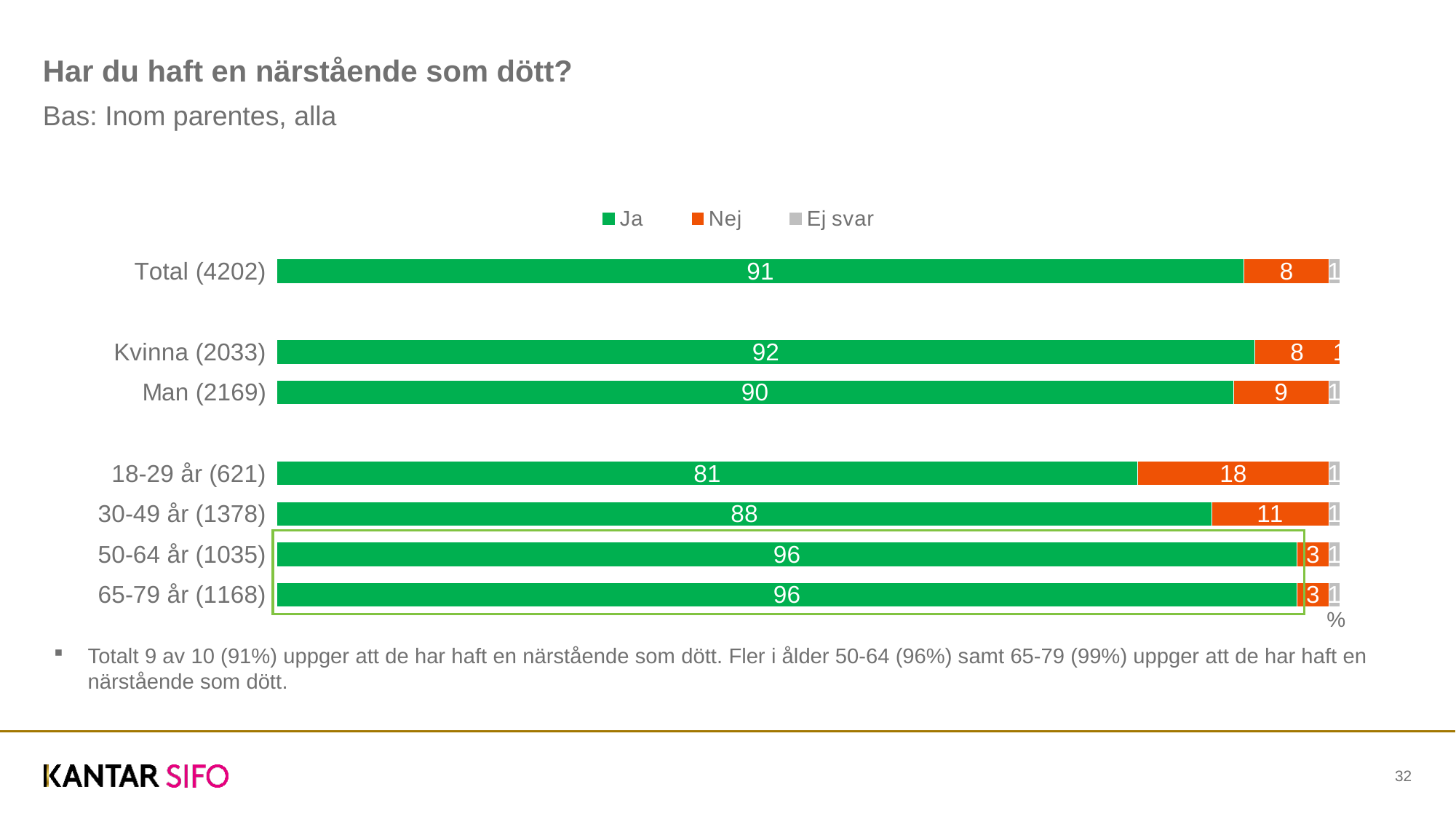
What is the "Ja" value for Total (4202)? 91 How many series does the legend list? 3 Which category has the highest "Nej" value? 18-29 år (621) How many categories are shown on the chart? 7 What is the difference between the "Ja" values for Kvinna (2033) and Man (2169)? 2 What is the "Nej" value for 18-29 år (621)? 18 What is the "Nej" value for Man (2169)? 9 What kind of chart is shown on the slide? Stacked bar chart What are the legend entries of the chart? Ja, Nej, Ej svar Which has a larger "Nej" value, 30-49 år (1378) or 50-64 år (1035)? 30-49 år (1378) Which category has the lowest "Ja" value? 18-29 år (621) What is the "Ja" value for 30-49 år (1378)? 88